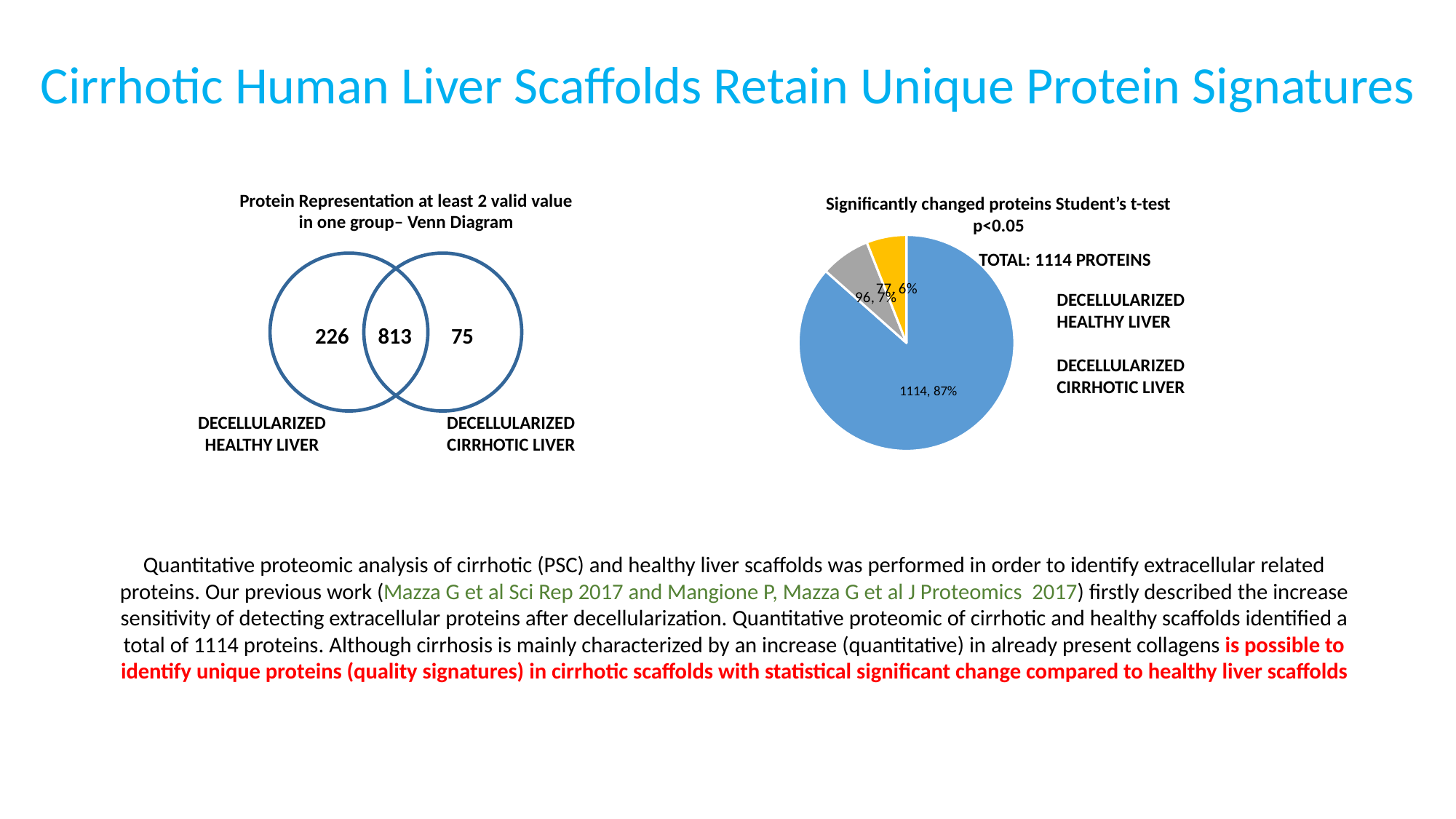
In the Venn diagram on the left, what is the difference between the healthy-only count and the cirrhotic-only count? 151 In the pie chart on the right, what is the difference between the gray slice value and the yellow slice value? 19 What kind of chart is shown on the right side of the slide? pie chart In the Venn diagram on the left, which has more unique proteins, decellularized healthy liver or decellularized cirrhotic liver? decellularized healthy liver In the Venn diagram on the left, how many proteins are unique to the decellularized cirrhotic liver? 75 In the pie chart on the right, how many slices are there? 3 In the pie chart on the right, which slice is the smallest? the yellow slice (77, 6%) In the pie chart on the right, what value is labelled on the yellow slice? 77 In the pie chart on the right, what value is labelled on the gray slice? 96 What total number of proteins is stated next to the pie chart on the right? 1114 PROTEINS In the pie chart on the right, what percentage is shown for the blue slice? 87% In the Venn diagram on the left, how many proteins are in the overlap between the two circles? 813